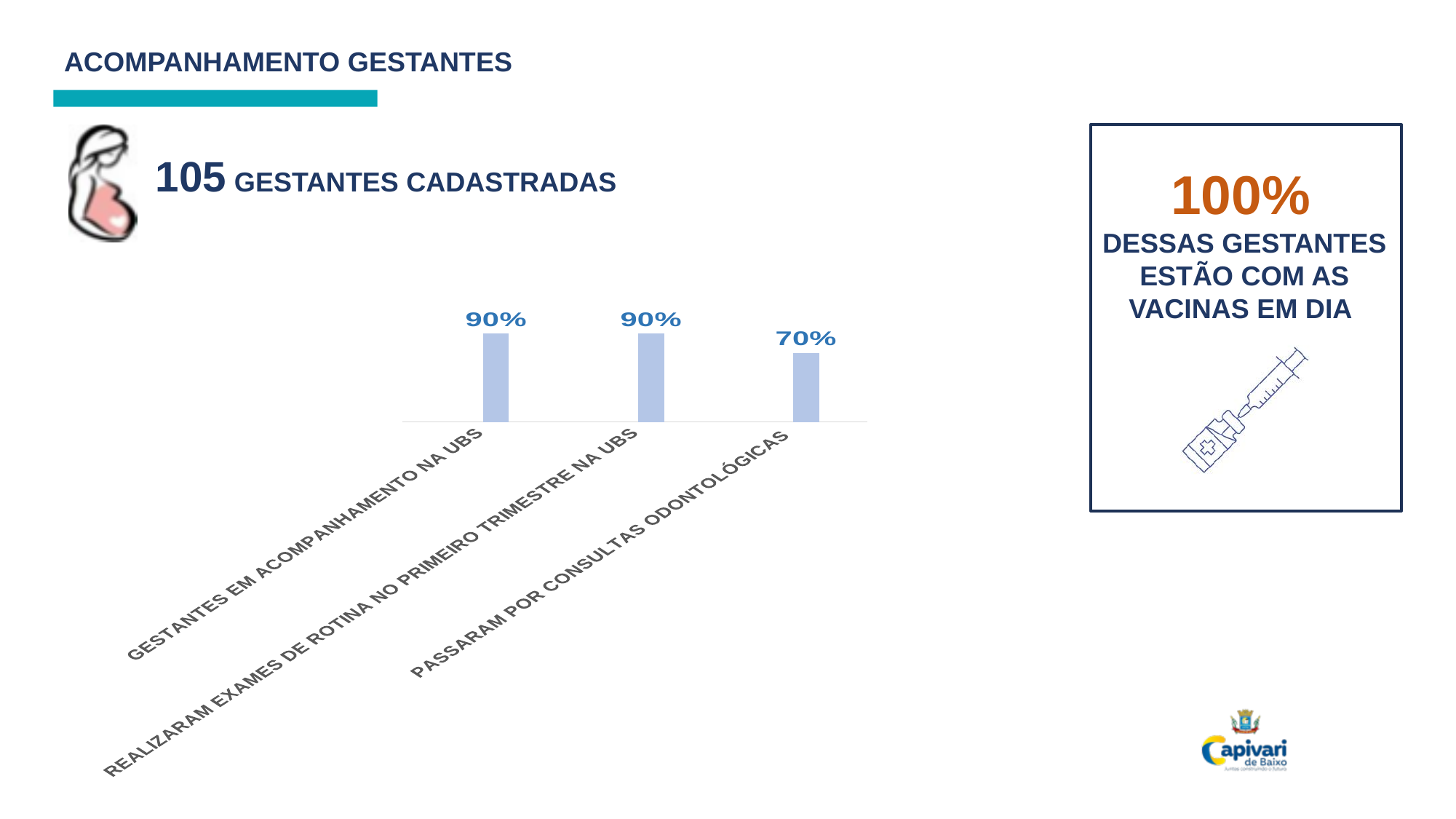
What colour are the bars in the chart? light blue How many categories are shown in the chart? 3 How many bars in the chart have a value of 90%? 2 What kind of chart is shown on the slide? bar chart Do GESTANTES EM ACOMPANHAMENTO NA UBS and REALIZARAM EXAMES DE ROTINA NO PRIMEIRO TRIMESTRE NA UBS have the same value? yes What is the value for GESTANTES EM ACOMPANHAMENTO NA UBS? 90% What is the difference between the value for GESTANTES EM ACOMPANHAMENTO NA UBS and the value for PASSARAM POR CONSULTAS ODONTOLÓGICAS? 20% What is the value for PASSARAM POR CONSULTAS ODONTOLÓGICAS? 70% Do the values rise or fall from the first category to the last along the x axis? fall What is the value for REALIZARAM EXAMES DE ROTINA NO PRIMEIRO TRIMESTRE NA UBS? 90% Which is larger: the value for REALIZARAM EXAMES DE ROTINA NO PRIMEIRO TRIMESTRE NA UBS or the value for PASSARAM POR CONSULTAS ODONTOLÓGICAS? REALIZARAM EXAMES DE ROTINA NO PRIMEIRO TRIMESTRE NA UBS Which category has the lowest value? PASSARAM POR CONSULTAS ODONTOLÓGICAS